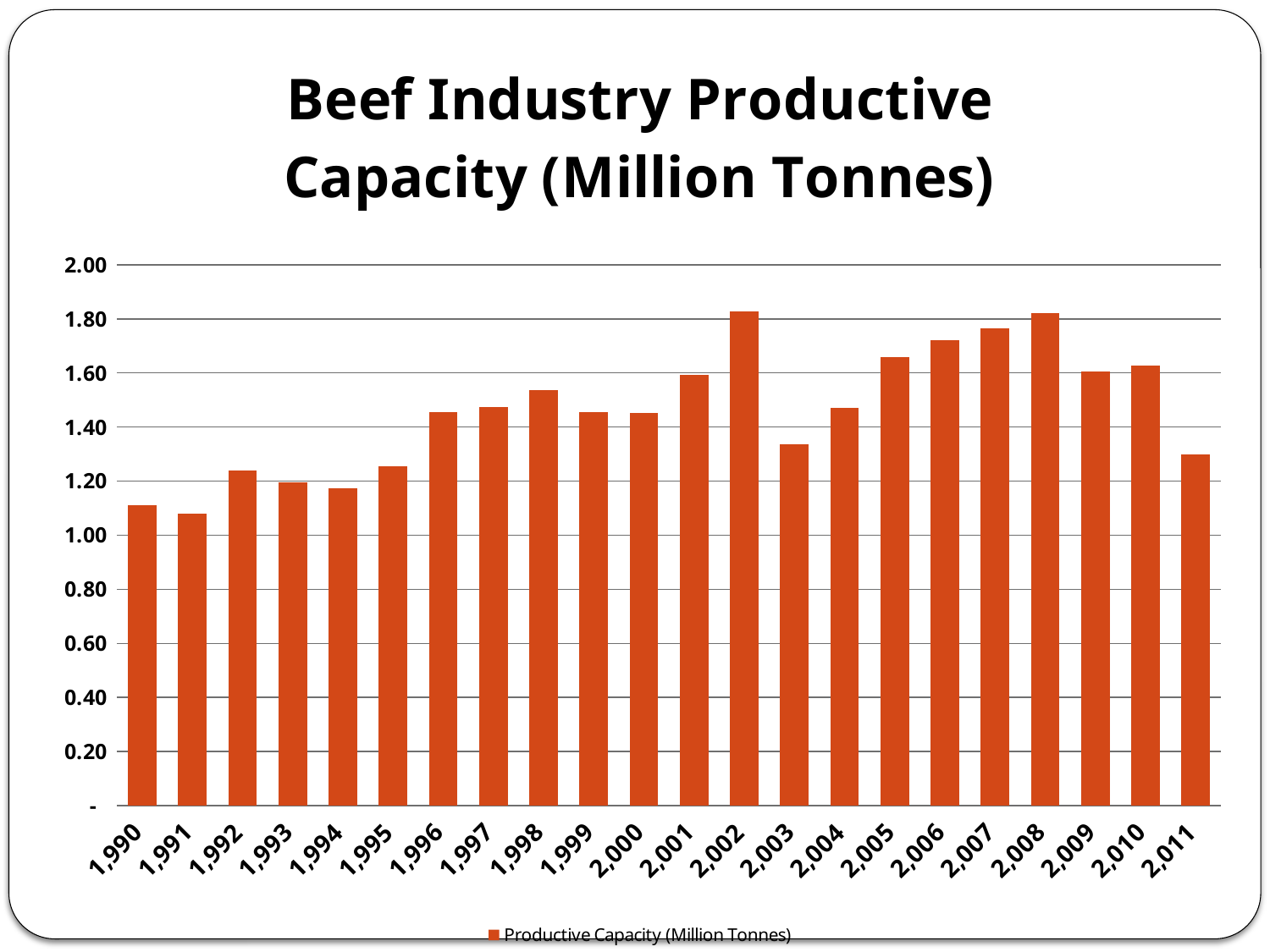
What is the legend entry shown below the chart? Productive Capacity (Million Tonnes) Is the value for 2006 greater or less than 1.60? greater Is the value for 2011 greater or less than 1.40? less Do the values rise or fall from 2003 to 2008? rise Which year has the larger value, 1991 or 1996? 1996 Which year has the larger value, 2002 or 2003? 2002 Is the value for 1990 greater or less than 1.00? greater What kind of chart is shown on the slide? Bar chart How many series does the legend list? 1 How many years (bars) are plotted on the chart? 22